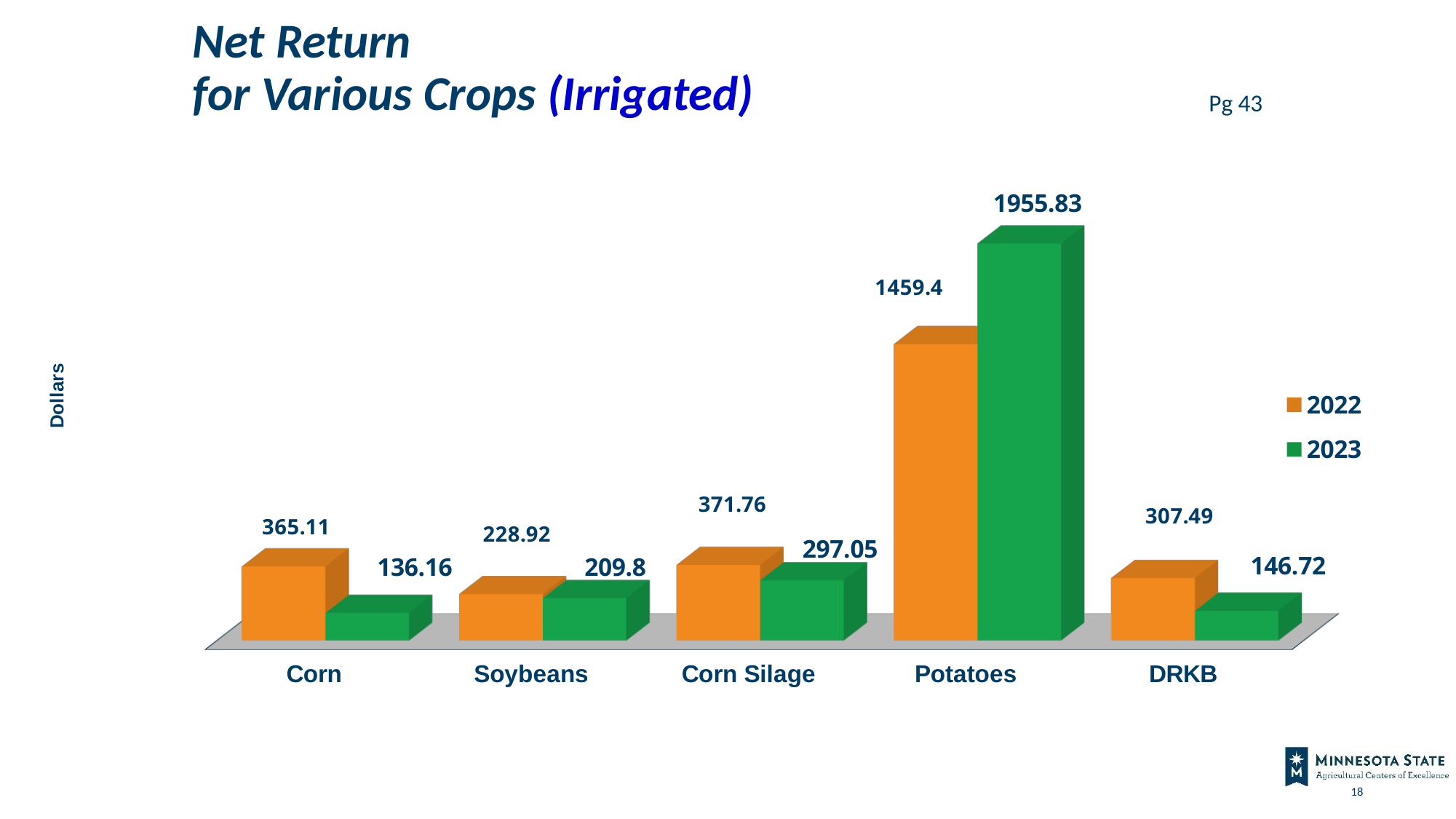
Which crop has the highest 2023 net return? Potatoes Which crop has the lowest 2023 net return? Corn What is the difference between the 2023 and 2022 net return for Potatoes? 496.43 How many crops are shown on the x axis? 5 What kind of chart is shown on the slide? Bar chart How many series does the legend list? 2 Which is larger for Corn Silage, the 2022 or the 2023 net return? 2022 What is the 2022 net return for Corn? 365.11 What is the 2023 net return for Potatoes? 1955.83 What is the 2022 net return for DRKB? 307.49 Which colour represents the 2023 series in the legend? Green What is the 2023 net return for Soybeans? 209.8